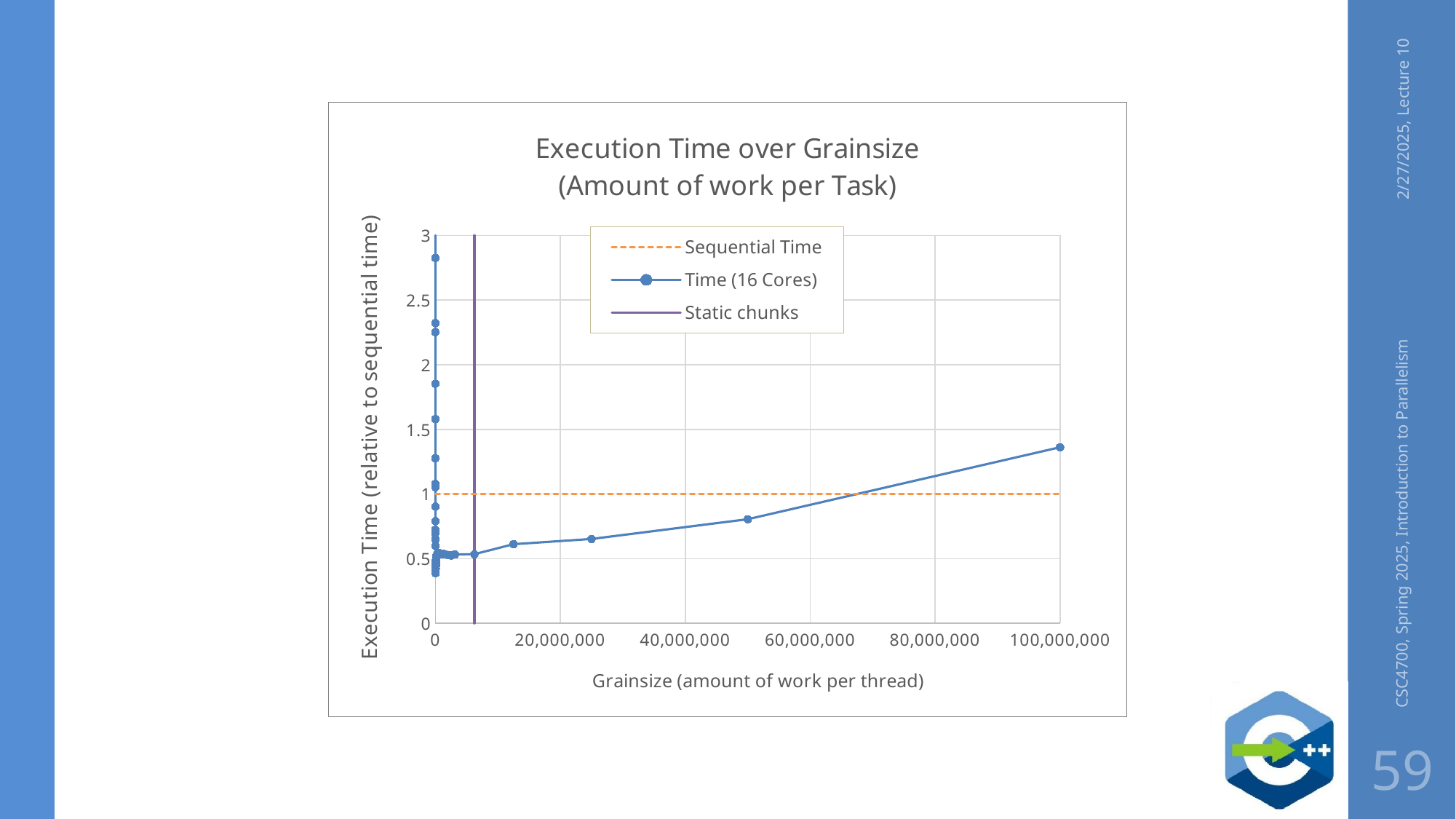
Is the Time (16 Cores) value at a grainsize of about 50,000,000 greater or less than 1? less Which is larger for Time (16 Cores): the value at a grainsize of 100,000,000 or at about 50,000,000? 100,000,000 Is the lowest Time (16 Cores) point greater or less than 0.5? less Does the Time (16 Cores) series rise or fall as grainsize increases from 20,000,000 to 100,000,000? rise Is the highest Time (16 Cores) point, near a grainsize of 0, greater or less than 2.5? greater At what execution time value does the Sequential Time line sit? 1 What is the label of the x axis? Grainsize (amount of work per thread) What kind of chart is shown on the slide? line chart What is the title of the chart? Execution Time over Grainsize (Amount of work per Task) How many series does the legend list? 3 What is the maximum value shown on the y axis? 3